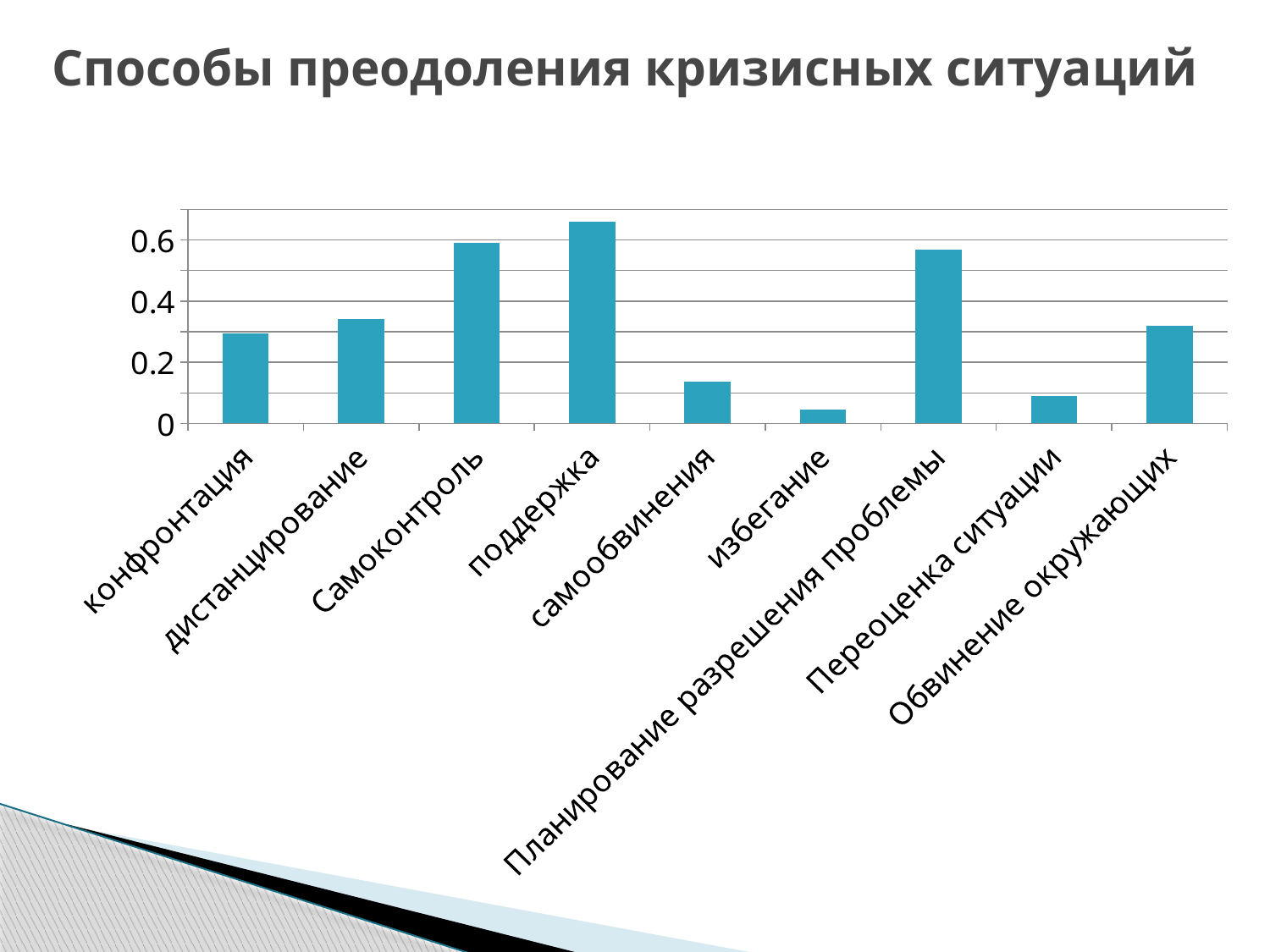
Is the value for Планирование разрешения проблемы greater or less than 0.4? greater Is the value for конфронтация greater or less than 0.4? less Which is larger, the value for Обвинение окружающих or the value for Переоценка ситуации? Обвинение окружающих Is the value for самообвинения greater or less than 0.2? less Which is larger, the value for поддержка or the value for конфронтация? поддержка What is the title of the chart? Способы преодоления кризисных ситуаций Which category has the lowest bar? избегание Which category has the highest bar? поддержка How many categories are shown on the x axis of the chart? 9 What kind of chart is shown on the slide? bar chart